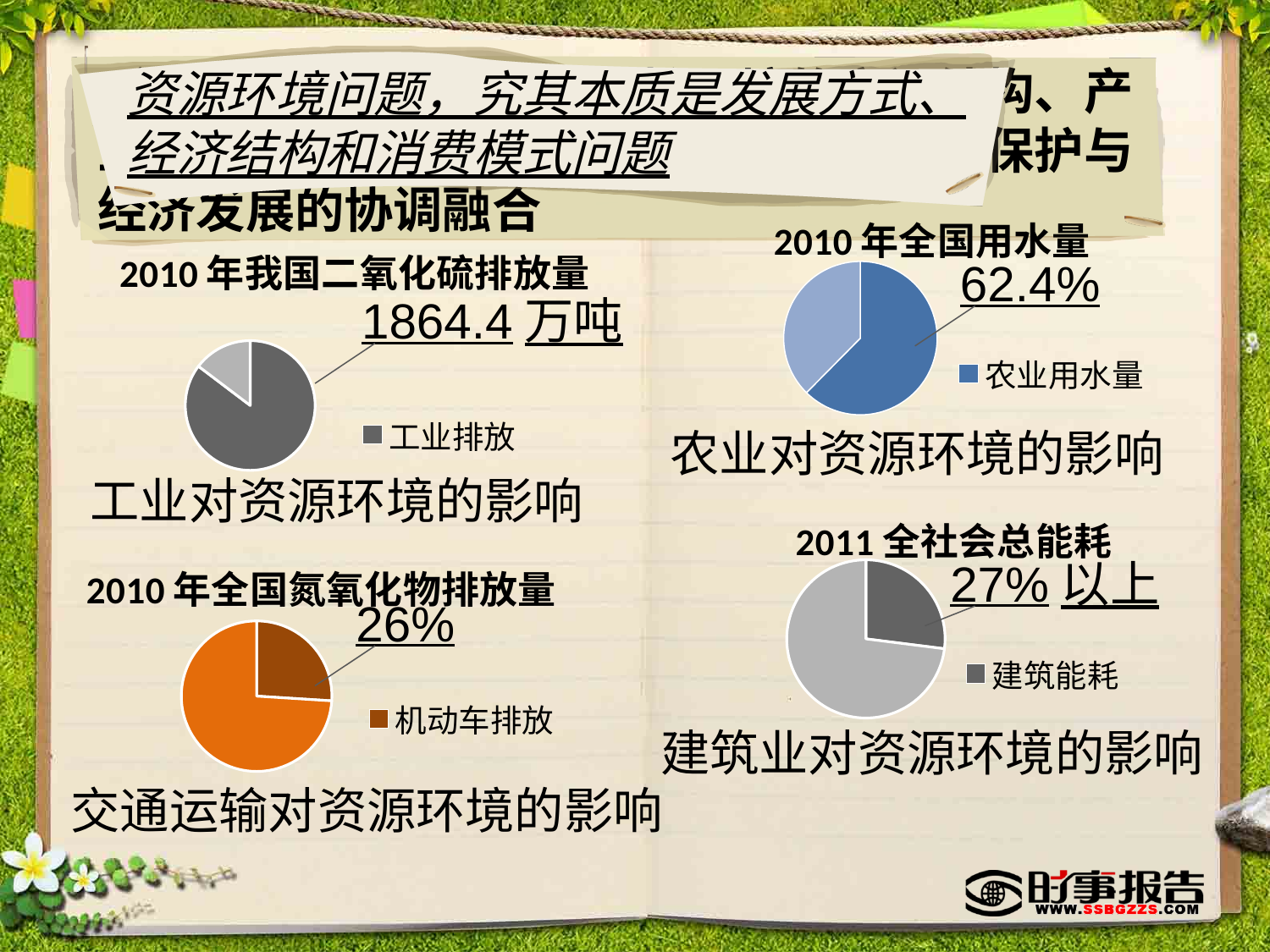
In the 2011 全社会总能耗 chart, is the 建筑能耗 slice larger or smaller than the other slice? smaller How many slices does the 2010 年全国氮氧化物排放量 pie chart have? 2 In the 2010 年我国二氧化硫排放量 chart, what value is labelled for 工业排放? 1864.4 万吨 In the 2011 全社会总能耗 chart, what value is labelled for 建筑能耗? 27% 以上 How many slices does the 2011 全社会总能耗 pie chart have? 2 In the 2010 年全国氮氧化物排放量 chart, is the 机动车排放 slice larger or smaller than the other slice? smaller What legend entry is shown for the 2010 年我国二氧化硫排放量 chart? 工业排放 In the 2010 年全国用水量 chart, is the 农业用水量 slice larger or smaller than the other slice? larger What kind of chart is used for 2010 年全国用水量? pie chart In the 2010 年全国用水量 chart, what share does 农业用水量 represent? 62.4% How many pie charts are shown on the slide? 4 In the 2010 年全国氮氧化物排放量 chart, what share does 机动车排放 represent? 26%